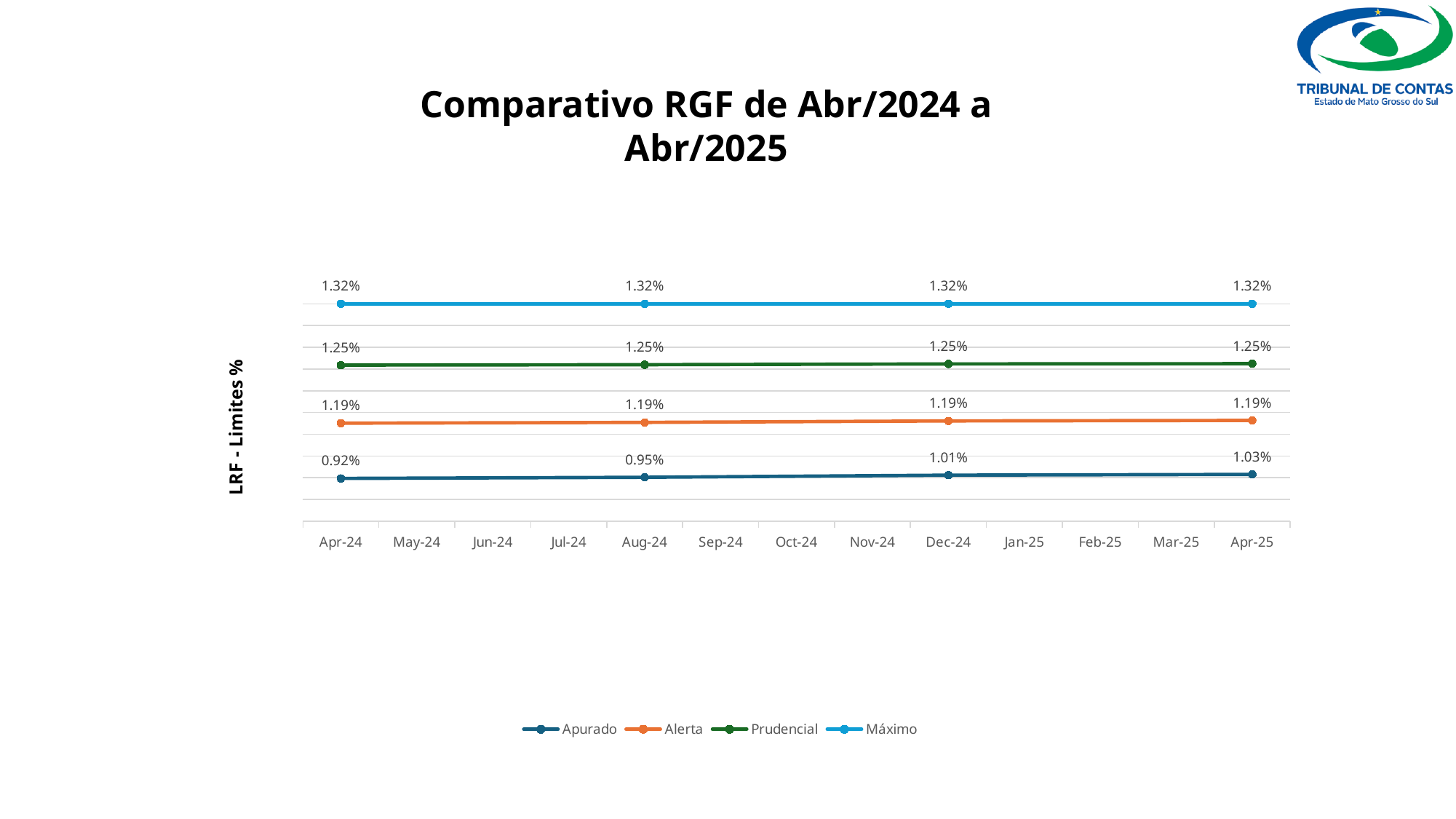
At which labelled point is the Apurado series highest? Apr-25 At which labelled point is the Apurado series lowest? Apr-24 What is the difference between the Máximo value and the Apurado value at Apr-25? 0.29% What is the value of the Alerta series at Dec-24? 1.19% Does the Apurado series rise or fall from Apr-24 to Apr-25? Rise What is the value of the Apurado series at Apr-24? 0.92% How many series does the legend list? 4 What is the value of the Apurado series at Apr-25? 1.03% What kind of chart is shown on the slide? Line chart What is the title of the chart? Comparativo RGF de Abr/2024 a Abr/2025 Which is larger at Dec-24, the Prudencial value or the Alerta value? Prudencial What is the value of the Máximo series at Aug-24? 1.32%